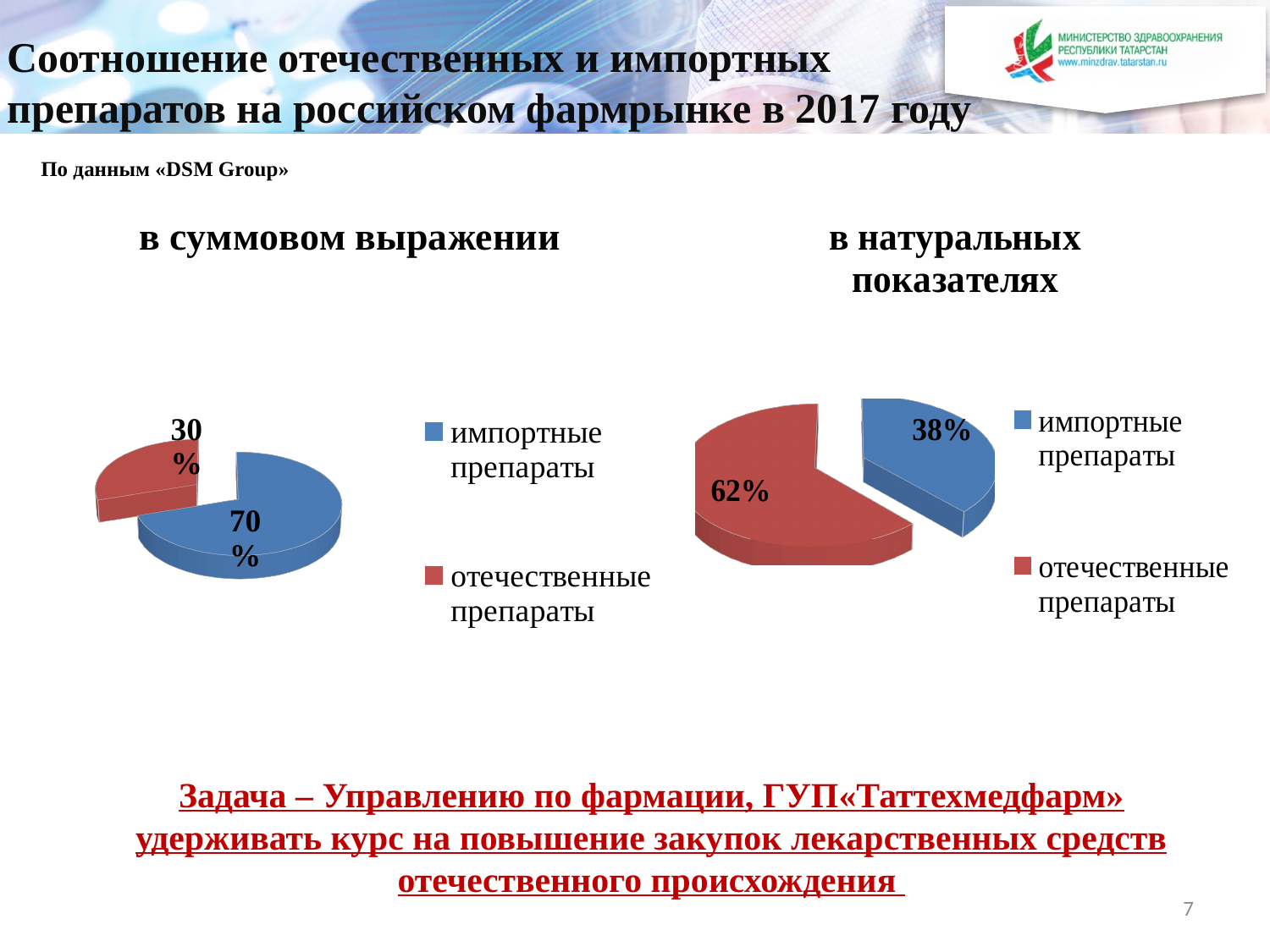
In the 'в натуральных показателях' chart, what share do импортные препараты have? 38% In the 'в суммовом выражении' chart, which category has the largest slice? импортные препараты In the 'в натуральных показателях' chart, what share do отечественные препараты have? 62% How many slices does the 'в суммовом выражении' pie chart have? 2 In the 'в натуральных показателях' chart, which is larger: импортные препараты or отечественные препараты? отечественные препараты In the 'в натуральных показателях' chart, what colour is the slice for отечественные препараты? red In the 'в суммовом выражении' chart, what share do импортные препараты have? 70% In the 'в натуральных показателях' chart, which category has the smallest slice? импортные препараты In the 'в суммовом выражении' chart, what share do отечественные препараты have? 30% In the 'в натуральных показателях' chart, what is the difference between the shares of отечественные препараты and импортные препараты? 24% In the 'в суммовом выражении' chart, what is the difference between the shares of импортные препараты and отечественные препараты? 40% What kind of chart is used in the 'в суммовом выражении' chart? pie chart